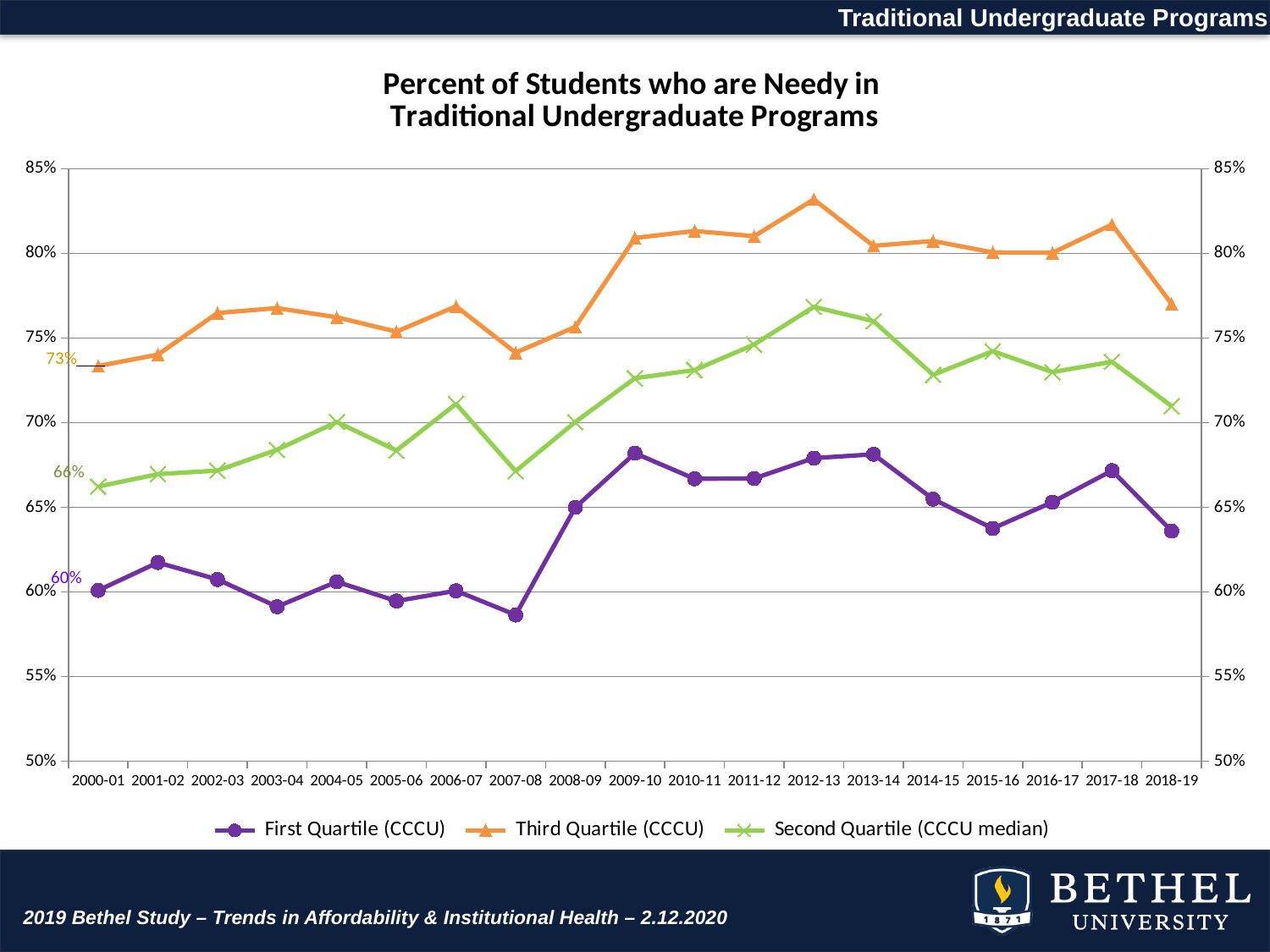
In which year does the Third Quartile (CCCU) series reach its highest value? 2012-13 Which series is drawn in orange with triangle markers? Third Quartile (CCCU) In 2000-01, what is the difference between the Third Quartile (CCCU) value and the First Quartile (CCCU) value? 13% Which is larger for Third Quartile (CCCU): the value in 2008-09 or the value in 2009-10? 2009-10 How many series does the legend list? 3 Is the value for Third Quartile (CCCU) in 2012-13 greater or less than 80%? greater What is the value for Second Quartile (CCCU median) in 2000-01? 66% How many academic years are plotted along the x axis? 19 What is the value for First Quartile (CCCU) in 2000-01? 60% What is the value for Third Quartile (CCCU) in 2000-01? 73% Is the value for First Quartile (CCCU) in 2007-08 greater or less than 60%? less What kind of chart is shown on the slide? line chart